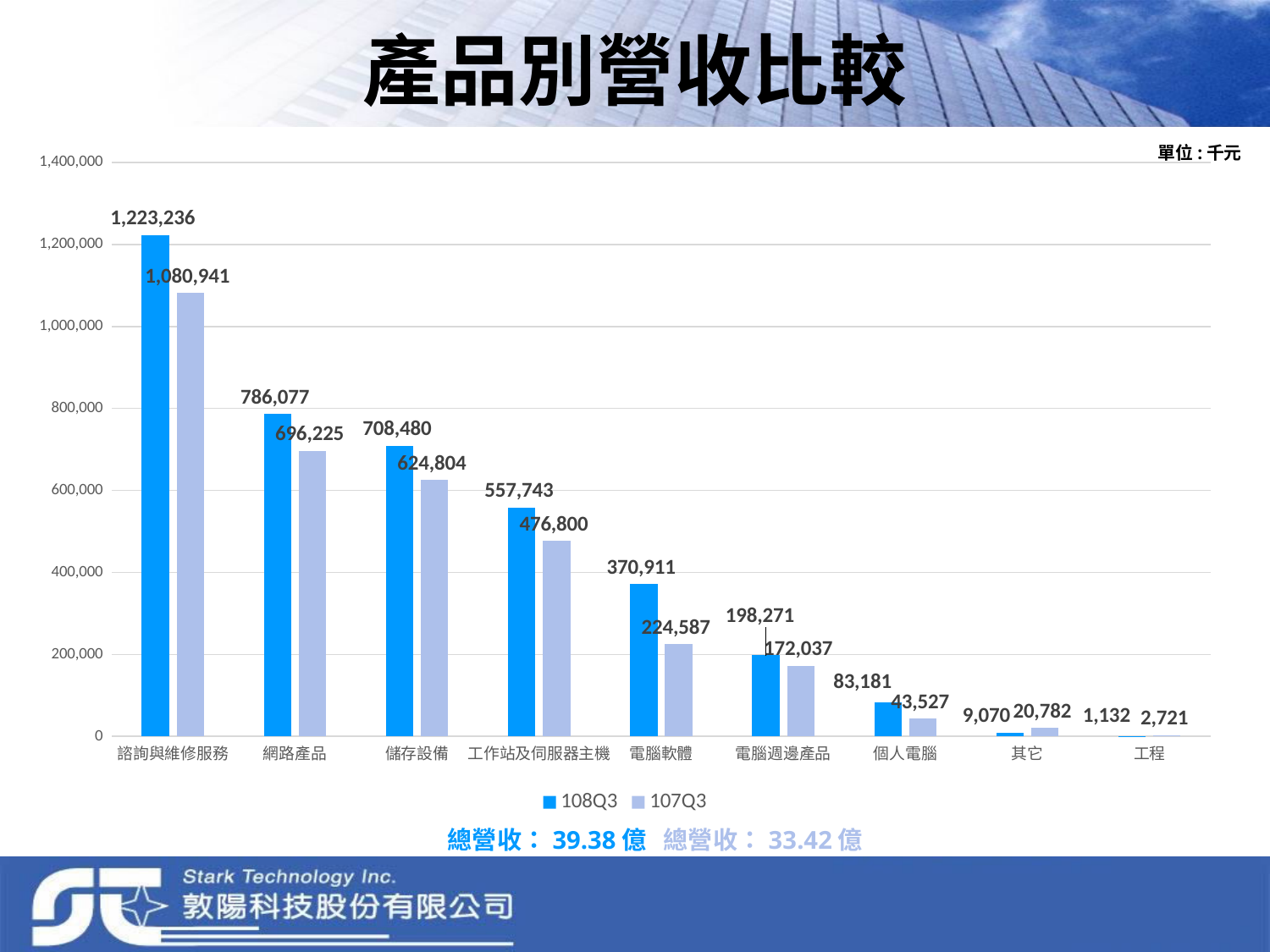
How many series does the legend list? 2 Which category has the highest 108Q3 value? 諮詢與維修服務 For 個人電腦, which series has the larger value, 108Q3 or 107Q3? 108Q3 What is the 107Q3 value for 其它? 20,782 Is the 107Q3 value for 工作站及伺服器主機 greater or less than 400,000? greater What is the 107Q3 value for 儲存設備? 624,804 What is the 108Q3 value for 電腦軟體? 370,911 What type of chart is shown on the slide? Bar chart What is the 108Q3 value for 諮詢與維修服務? 1,223,236 How many product categories are shown on the x axis? 9 Which category has the lowest 107Q3 value? 工程 What is the difference between the 108Q3 and 107Q3 values for 網路產品? 89,852